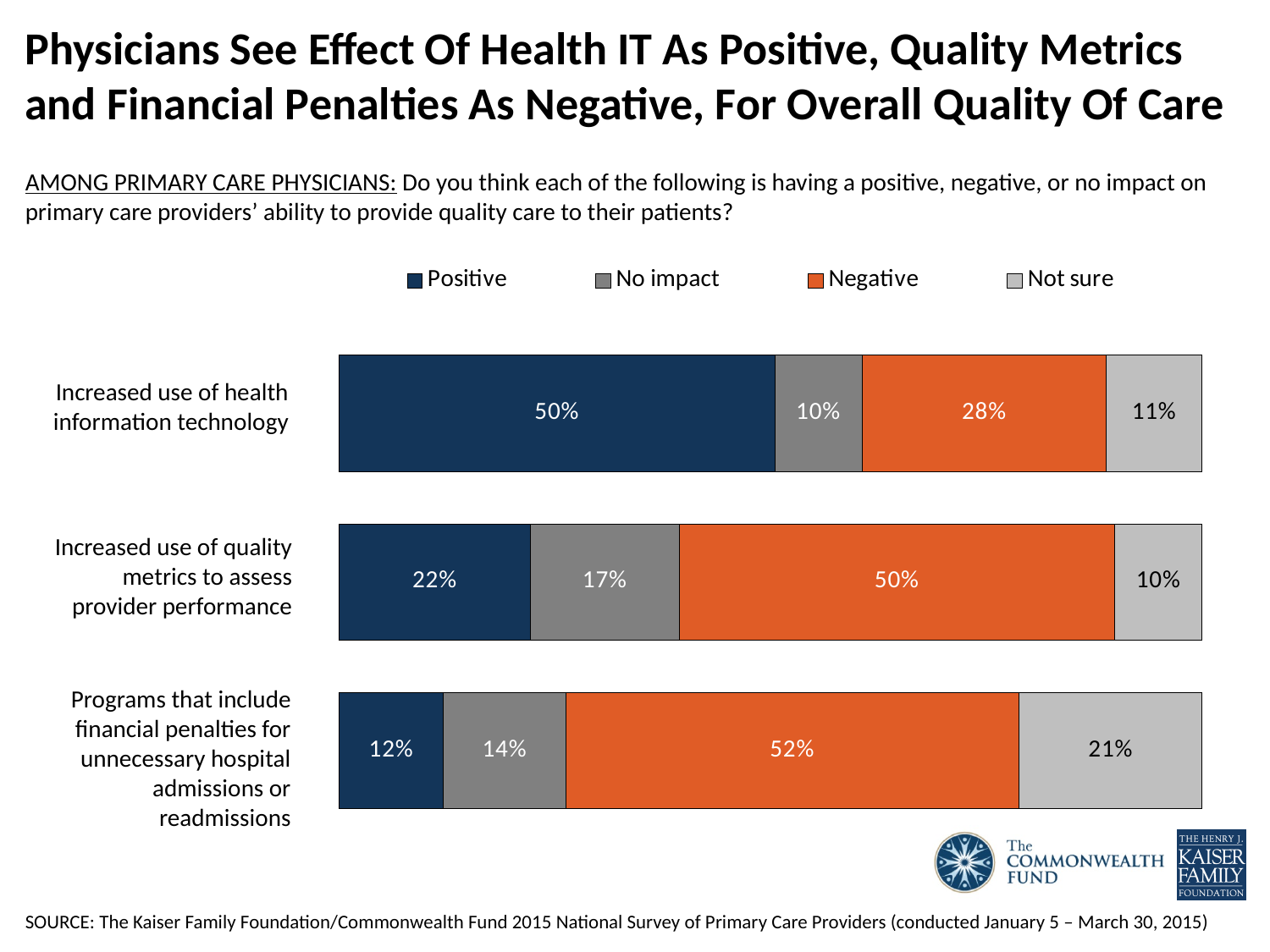
Which colour represents the 'Negative' series in the chart? Orange What percentage of physicians said increased use of health information technology has a positive impact? 50% What is the 'No impact' value for increased use of health information technology? 10% How many series does the legend list? 4 What is the 'Not sure' value for increased use of quality metrics to assess provider performance? 10% What kind of chart is shown on the slide? Stacked bar chart Which is larger: the 'Not sure' value for programs that include financial penalties, or the 'Not sure' value for increased use of health information technology? Programs that include financial penalties What is the difference between the 'Negative' and 'Positive' percentages for increased use of quality metrics to assess provider performance? 28 percentage points What percentage of physicians said programs that include financial penalties for unnecessary hospital admissions or readmissions have a negative impact? 52% Which item has the highest 'Positive' percentage? Increased use of health information technology How many items (bars) are shown in the chart? 3 Which item has the lowest 'Negative' percentage? Increased use of health information technology